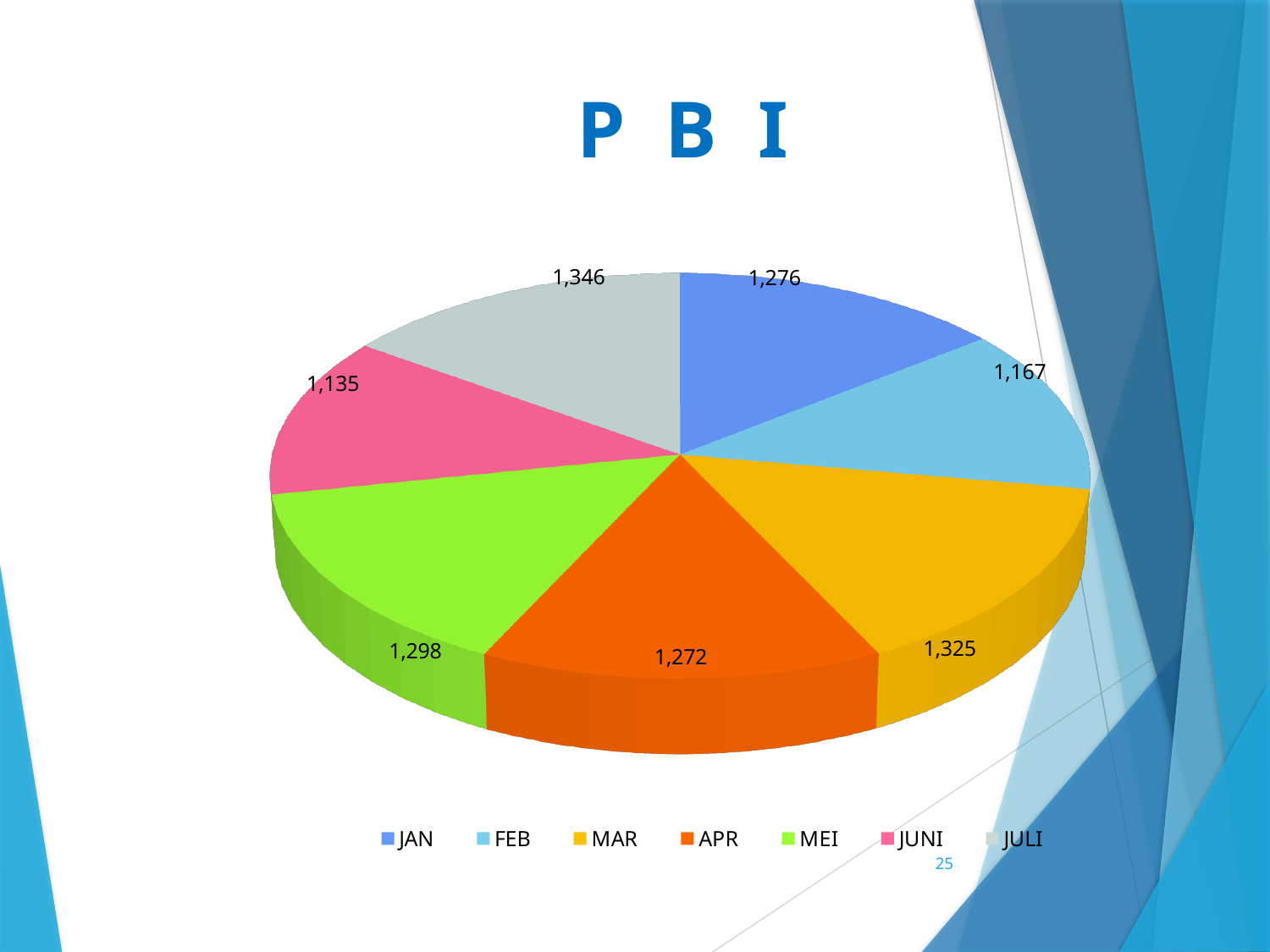
What is the title of the chart? P B I Which is larger, the value for MAR or the value for MEI? MAR What is the difference between the values for JULI and JUNI? 211 What kind of chart is shown on the slide? Pie chart What colour is the APR slice in the pie chart? Orange What is the value for JUNI in the pie chart? 1,135 How many slices does the pie chart have? 7 Which month has the smallest slice in the pie chart? JUNI What is the value for JAN in the pie chart? 1,276 What is the difference between the values for MAR and FEB? 158 What is the value for MAR in the pie chart? 1,325 Which month has the largest slice in the pie chart? JULI